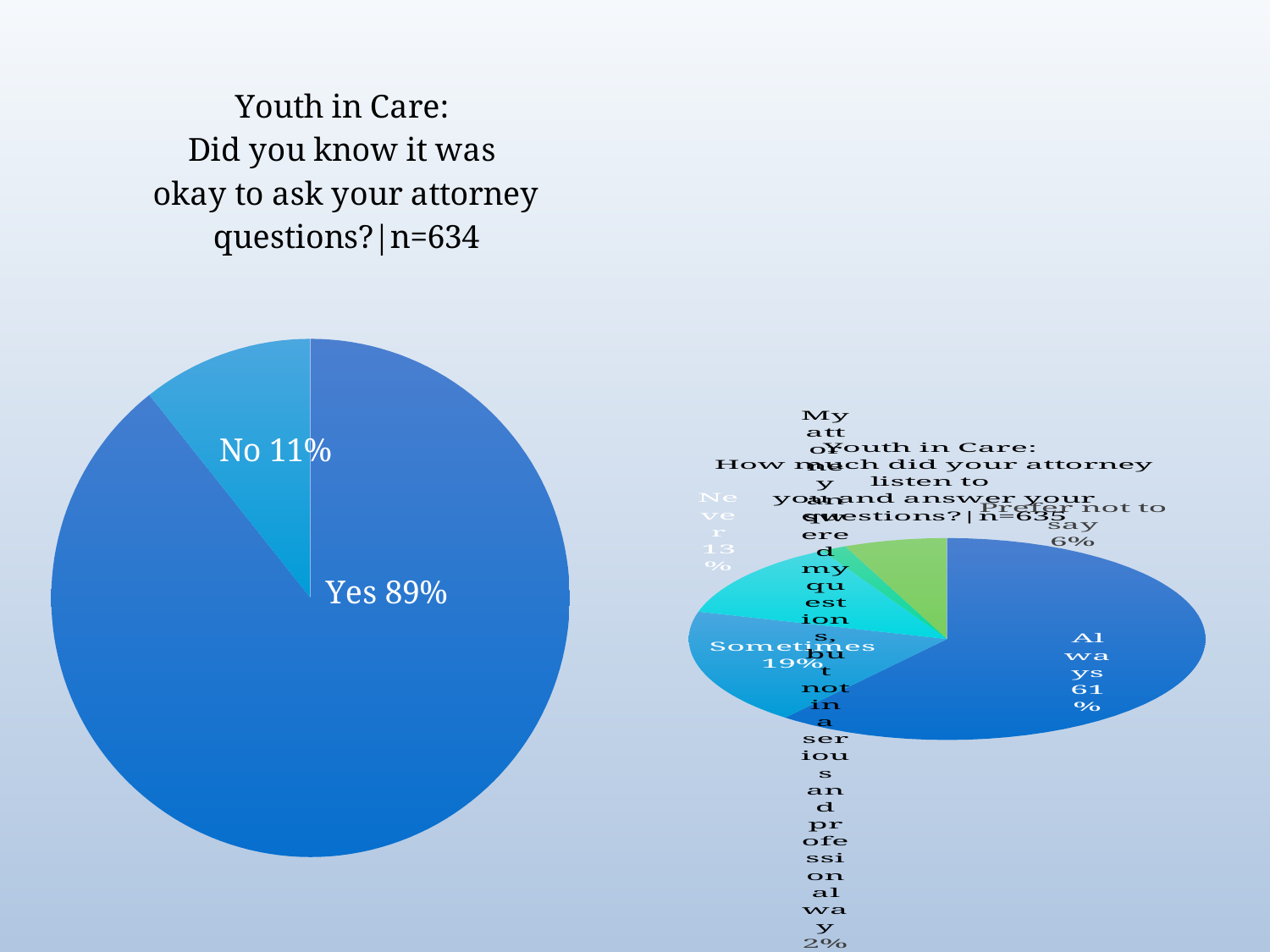
In the left pie chart (Did you know it was okay to ask your attorney questions?), what share of respondents answered No? 11% In the right pie chart (How much did your attorney listen to you and answer your questions?), what share of respondents chose Prefer not to say? 6% What is the sample size (n) shown in the title of the left pie chart? n=634 In the right pie chart (How much did your attorney listen to you and answer your questions?), which response has the smallest share? My attorney answered my questions, but not in a serious and professional way (2%) In the right pie chart (How much did your attorney listen to you and answer your questions?), what share of respondents answered Sometimes? 19% What type of chart is used on the left side of the slide? Pie chart In the right pie chart (How much did your attorney listen to you and answer your questions?), what share of respondents answered Always? 61% In the left pie chart (Did you know it was okay to ask your attorney questions?), what share of respondents answered Yes? 89% In the left pie chart (Did you know it was okay to ask your attorney questions?), what is the difference in percentage points between Yes and No? 78 percentage points In the left pie chart (Did you know it was okay to ask your attorney questions?), which response has the largest share? Yes In the left pie chart (Did you know it was okay to ask your attorney questions?), how many slices are there? 2 In the right pie chart (How much did your attorney listen to you and answer your questions?), what share of respondents answered Never? 13%